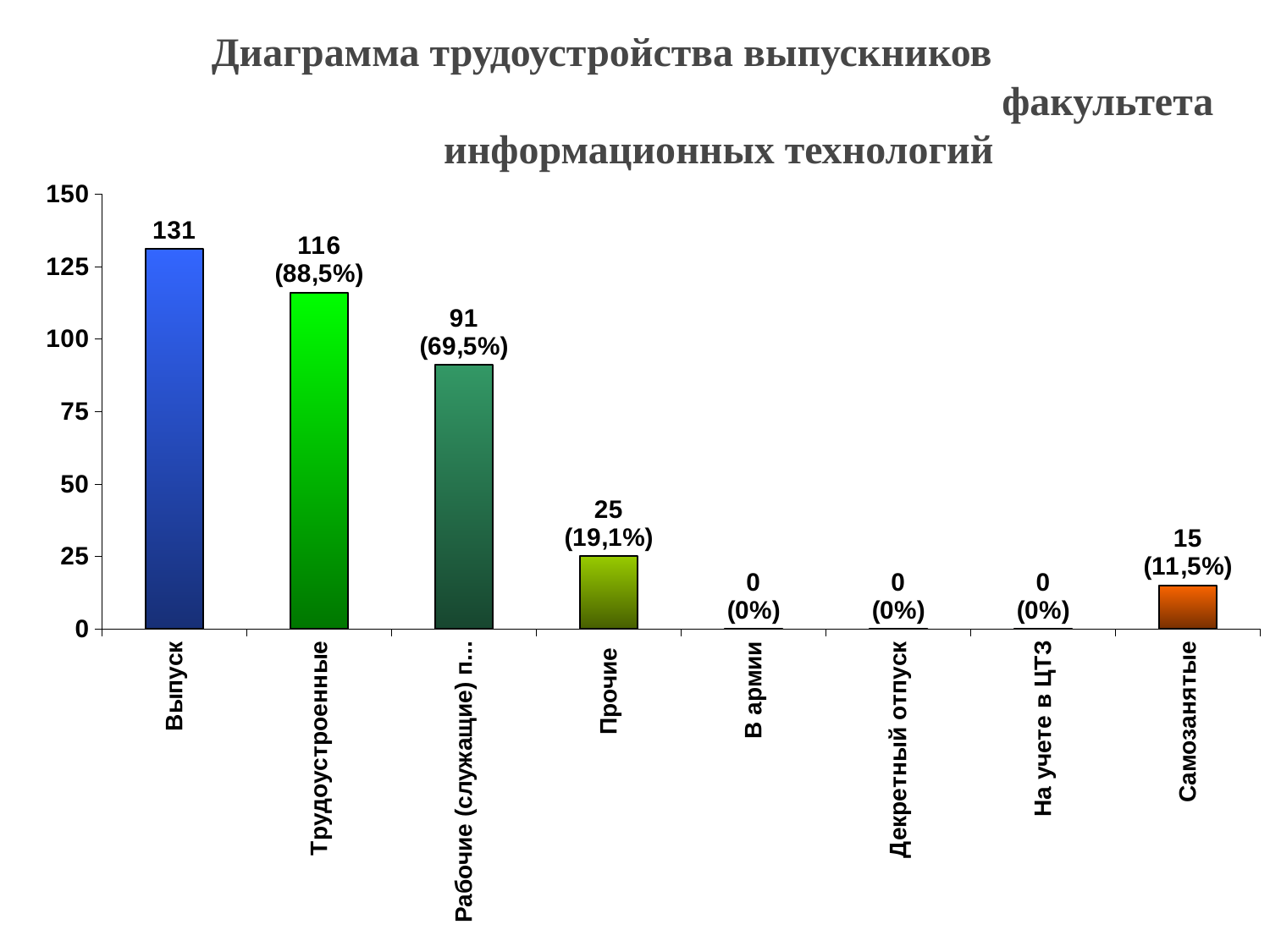
Which category has the highest value? Выпуск What is the value for Выпуск? 131 Which is larger, the value for Прочие or the value for Самозанятые? Прочие How many categories are shown on the x axis? 8 What kind of chart is shown on the slide? Bar chart What is the difference between the values for Выпуск and Трудоустроенные? 15 What is the value for Самозанятые? 15 What is the value for В армии? 0 What percentage is shown for Трудоустроенные? 88,5% What is the value for Прочие? 25 What is the value for Трудоустроенные? 116 What percentage is shown for Самозанятые? 11,5%